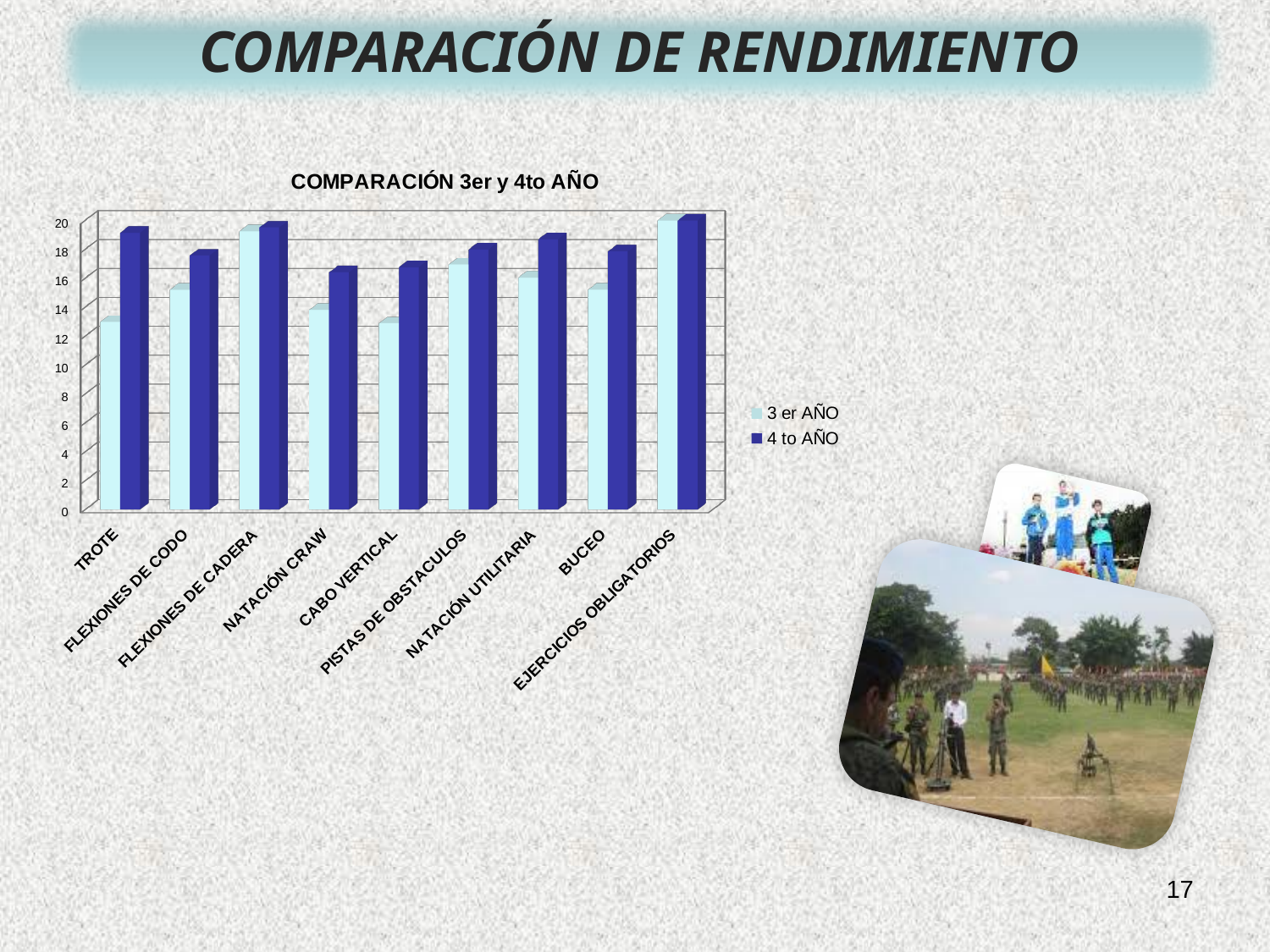
Is the value for TROTE in the 4 to AÑO series greater or less than 18? greater For TROTE, which series has the larger value, 3 er AÑO or 4 to AÑO? 4 to AÑO What kind of chart is shown on the slide? Bar chart How many series does the chart legend list? 2 Is the value for NATACIÓN CRAW in the 4 to AÑO series greater or less than 14? greater How many categories are shown on the x axis of the chart? 9 Is the value for TROTE in the 3 er AÑO series greater or less than 16? less For CABO VERTICAL, which series has the larger value, 3 er AÑO or 4 to AÑO? 4 to AÑO What is the title of the chart? COMPARACIÓN 3er y 4to AÑO Which series is shown in dark blue in the chart? 4 to AÑO